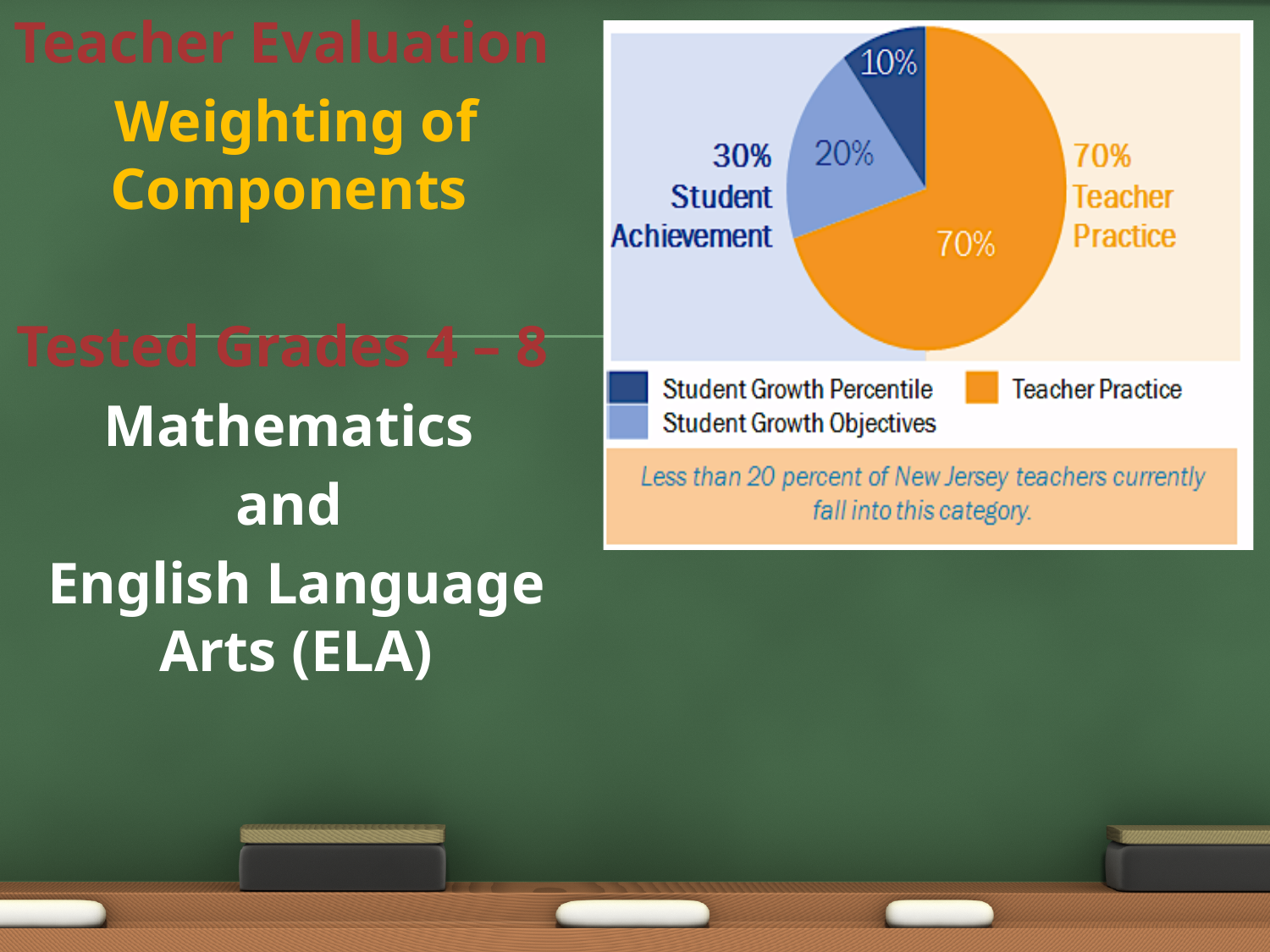
What kind of chart is shown on the slide? pie chart How many entries does the legend list? 3 What share of the pie does Student Growth Percentile represent? 10% What colour is the Teacher Practice slice? orange Which slice of the pie is the largest? Teacher Practice What share of the pie does Student Growth Objectives represent? 20% What is the combined share of Student Growth Percentile and Student Growth Objectives? 30% What is the difference between the Teacher Practice share and the Student Growth Objectives share? 50% How many slices does the pie chart have? 3 What share of the pie does Teacher Practice represent? 70% Which slice of the pie is the smallest? Student Growth Percentile Which is larger, the Student Growth Objectives slice or the Student Growth Percentile slice? Student Growth Objectives